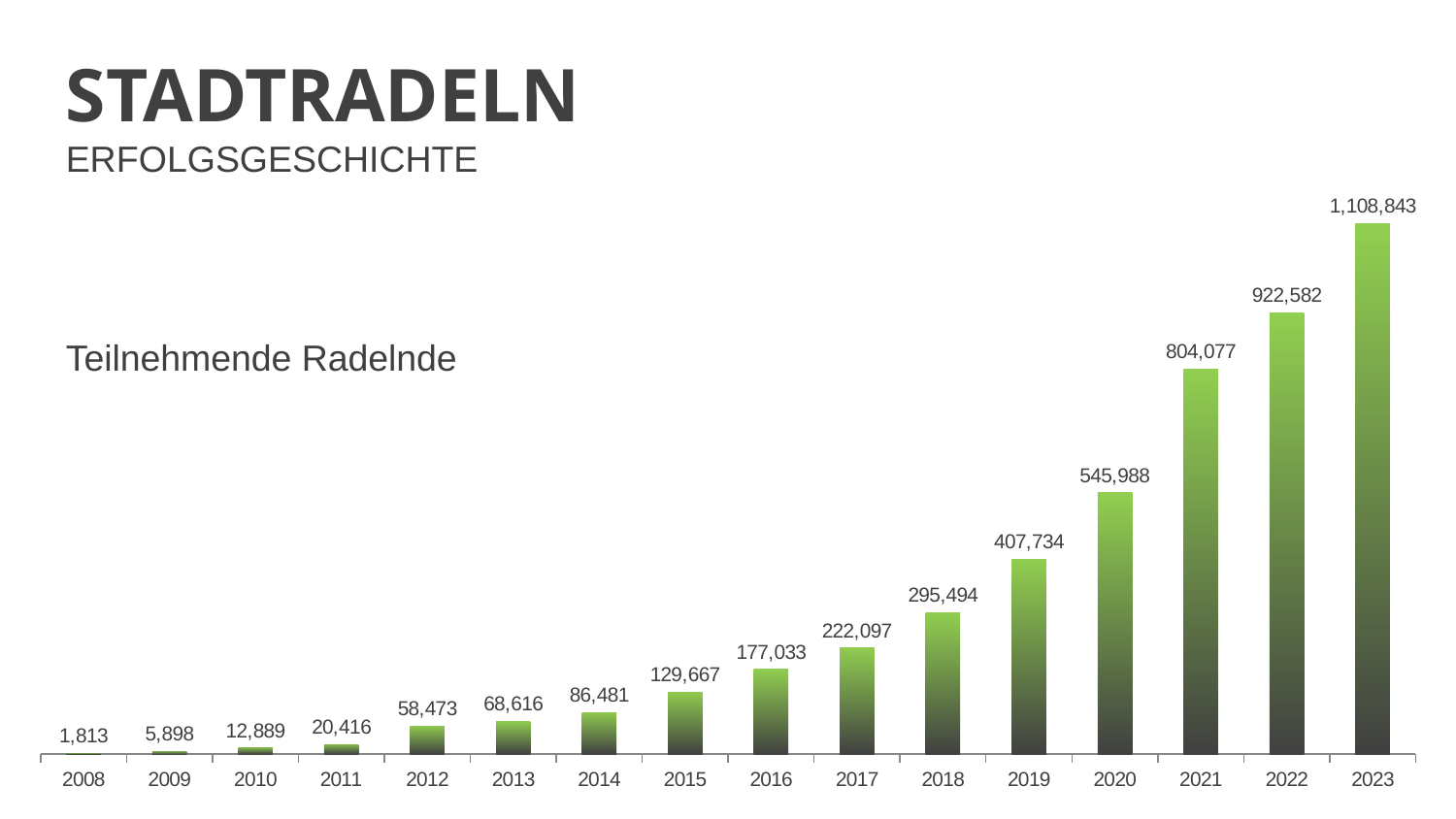
Which is larger, the value for 2014 or the value for 2013? 2014 Do the values rise or fall from 2008 to 2023? rise What is the value for 2020? 545,988 Which year has the highest value? 2023 What type of chart is shown on the slide? bar chart Which year has the lowest value? 2008 What is the difference between the values for 2023 and 2022? 186,261 What is the value for 2016? 177,033 What is the value for 2008? 1,813 What is the difference between the values for 2020 and 2019? 138,254 How many years (bars) are shown in the chart? 16 What is the value for 2023? 1,108,843